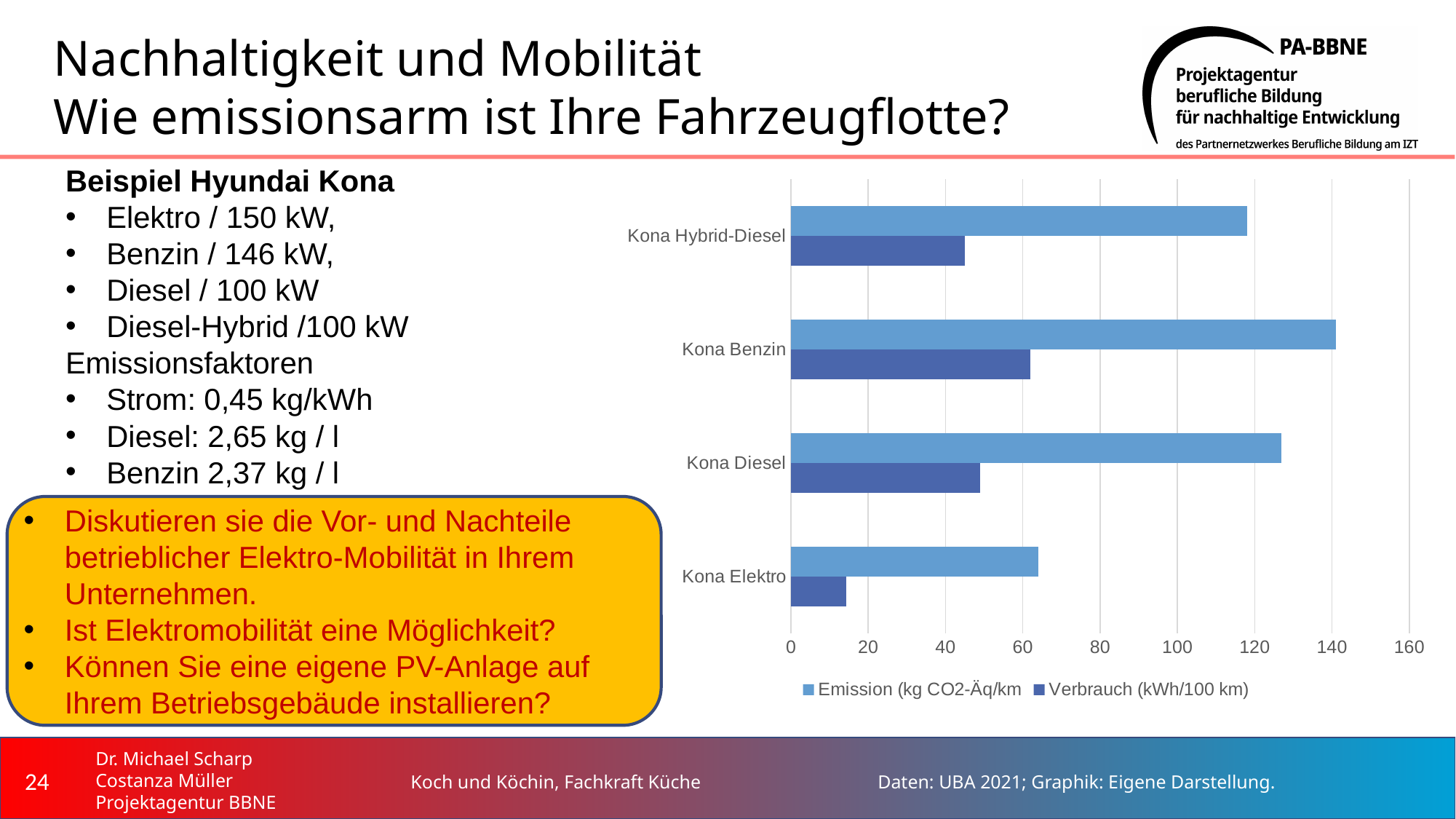
How many series does the chart legend list? 2 How many vehicle categories are shown in the chart? 4 Is the Emission value for Kona Benzin greater or less than 120? greater Which category has the lowest Emission (kg CO2-Äq/km) value? Kona Elektro Which category has the highest Verbrauch (kWh/100 km) value? Kona Benzin Is the Emission value for Kona Elektro greater or less than 80? less What is the name of the second series in the chart legend? Verbrauch (kWh/100 km) What kind of chart is shown on the slide? bar chart Which category has the lowest Verbrauch (kWh/100 km) value? Kona Elektro Is the Verbrauch value for Kona Elektro greater or less than 20? less Which has the larger Emission value, Kona Diesel or Kona Hybrid-Diesel? Kona Diesel Which category has the highest Emission (kg CO2-Äq/km) value? Kona Benzin